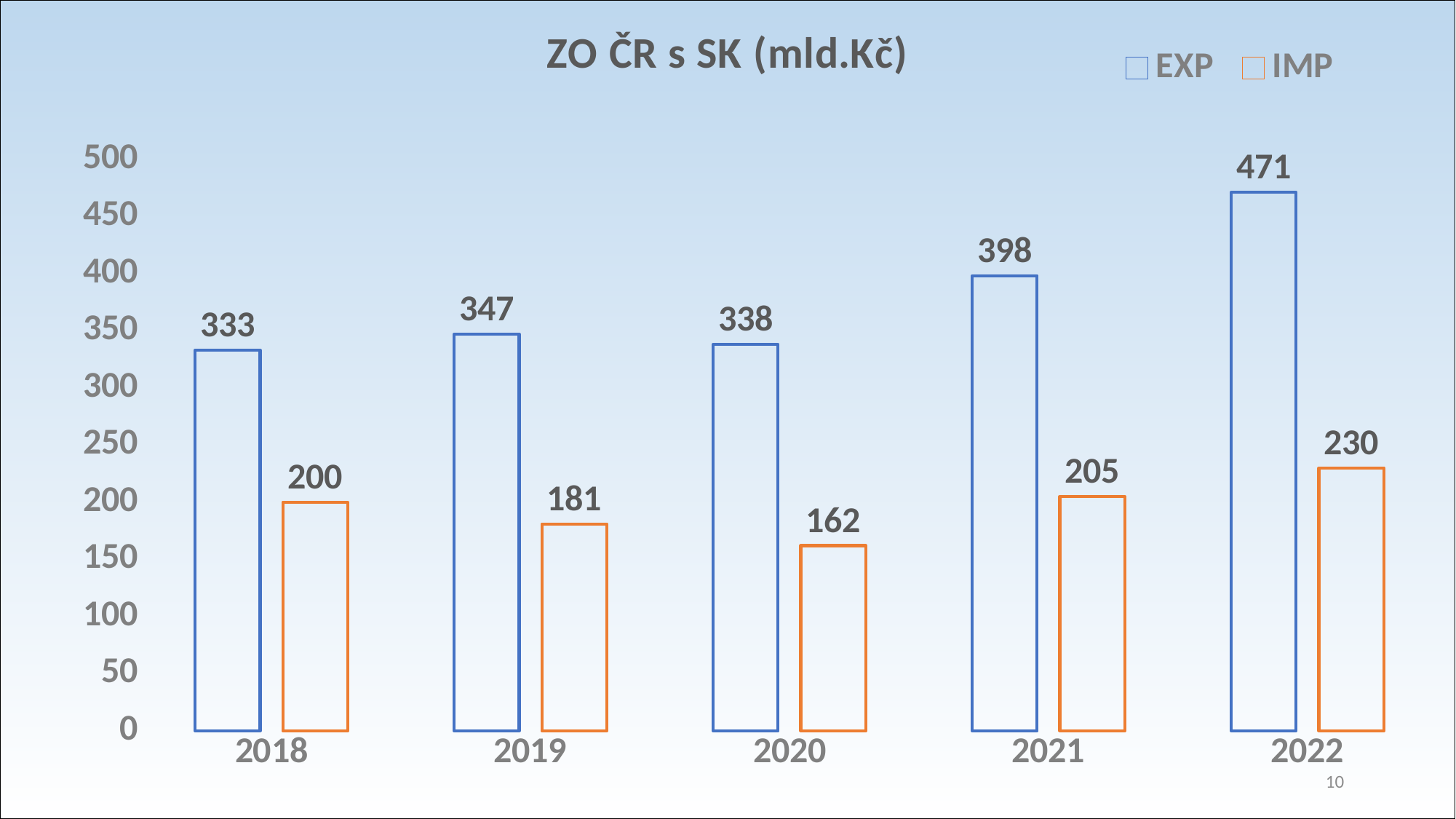
What is the EXP value for 2022? 471 What is the difference between EXP and IMP in 2021? 193 Is the IMP value for 2022 greater or less than 250? less How many series does the legend list? 2 Which is larger, the EXP value for 2019 or the EXP value for 2020? EXP value for 2019 Which year has the lowest IMP value? 2020 How many years are shown on the x axis? 5 Which year has the highest EXP value? 2022 What is the title of the chart? ZO ČR s SK (mld.Kč) What is the IMP value for 2018? 200 What kind of chart is shown on the slide? Bar chart What is the IMP value for 2020? 162